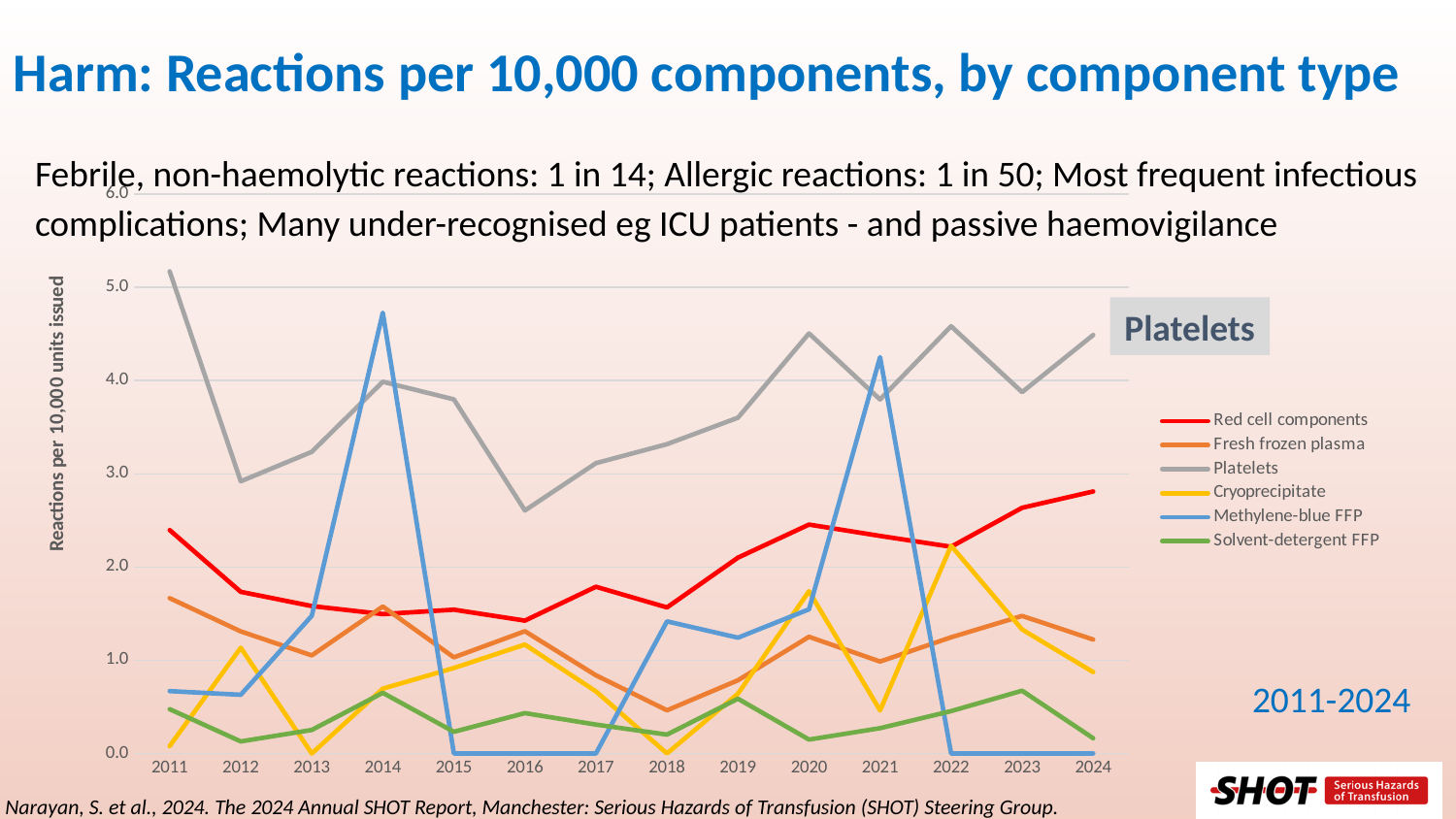
Which series has the highest value in 2014? Methylene-blue FFP Which series has the highest value in 2011? Platelets In 2024, which is larger: the value for Platelets or the value for Red cell components? Platelets Is the value for Red cell components in 2024 greater or less than 2.0? greater Is the value for Platelets in 2011 greater or less than 4.0? greater Does the Red cell components line rise or fall from 2018 to 2024? rise What is the value for Methylene-blue FFP in 2016? 0.0 Which series has the lowest value in 2011? Cryoprecipitate Is the value for Solvent-detergent FFP in 2011 greater or less than 1.0? less How many years are plotted along the x axis of the chart? 14 How many series does the chart legend list? 6 What kind of chart is shown on the slide? line chart